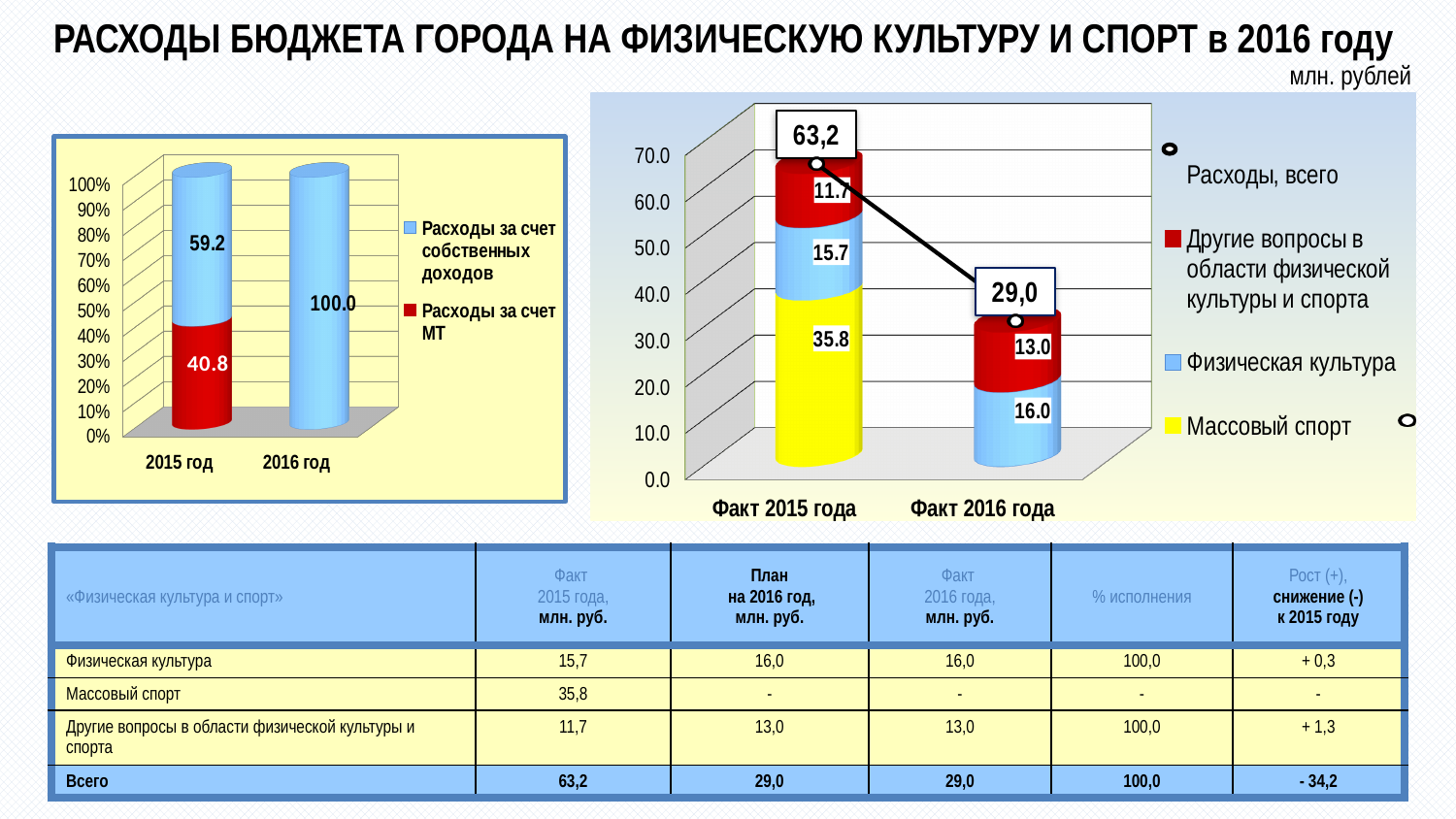
On the right chart, what is the value for 'Другие вопросы в области физической культуры и спорта' in Факт 2015 года? 11.7 On the right chart, what is the difference between the totals for Факт 2015 года and Факт 2016 года? 34,2 On the right chart, what is the value for 'Массовый спорт' in Факт 2015 года? 35.8 On the left chart, what is the value for 'Расходы за счет собственных доходов' in 2016 год? 100.0 On the right chart, how many categories are shown on the x axis? 2 On the right chart, what is the total 'Расходы, всего' for Факт 2016 года? 29,0 On the right chart, what is the value for 'Физическая культура' in Факт 2016 года? 16.0 On the left chart, what is the value for 'Расходы за счет собственных доходов' in 2015 год? 59.2 On the left chart, what is the value for 'Расходы за счет МТ' in 2015 год? 40.8 How many series does the legend of the left chart list? 2 On the right chart, which category has the higher total, Факт 2015 года or Факт 2016 года? Факт 2015 года What kind of chart is the right chart? Stacked bar chart